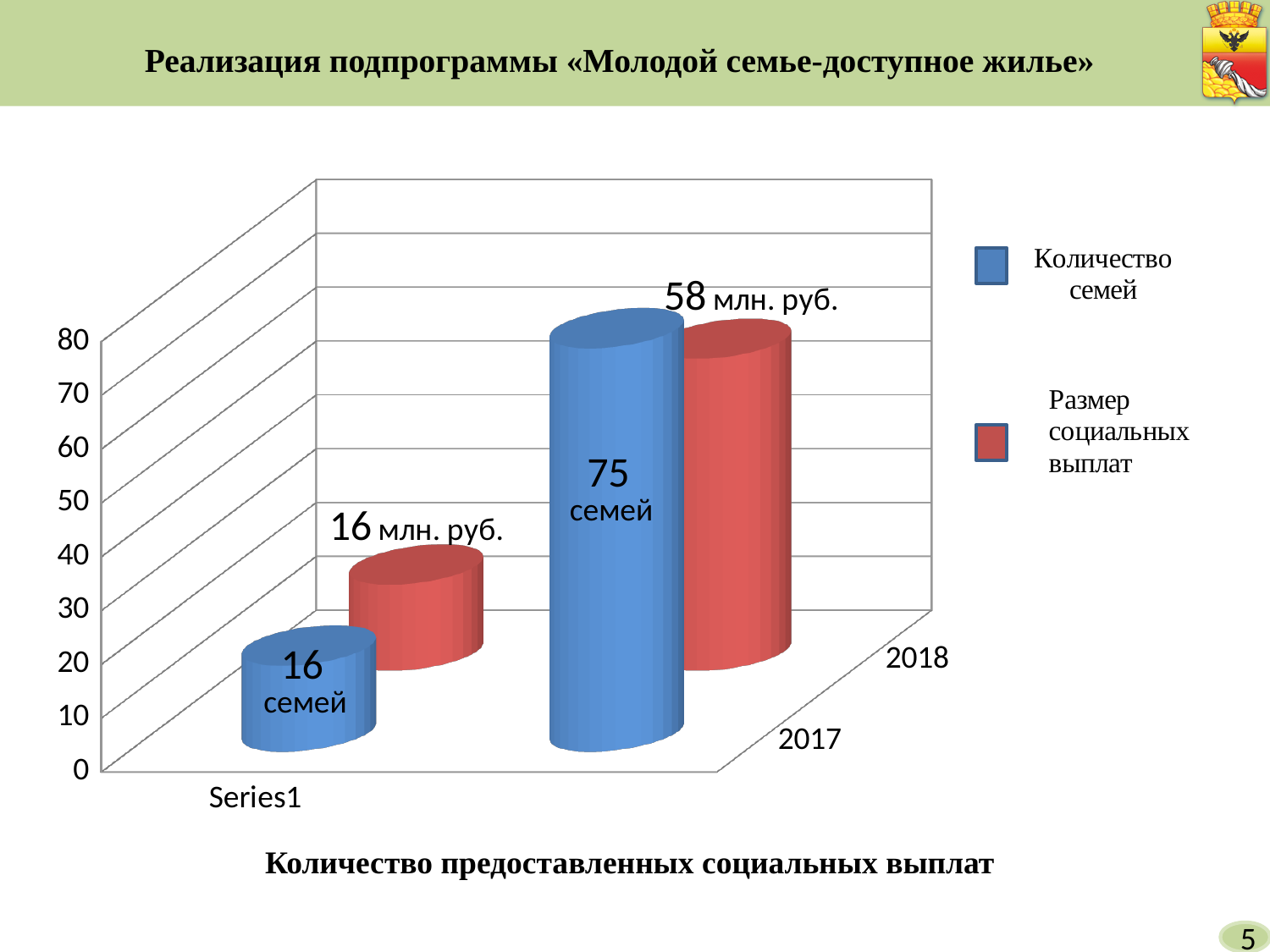
What is the difference in social payments between 2018 and 2017? 42 млн. руб. What is the size of social payments (Размер социальных выплат) for 2017? 16 млн. руб. What are the two series named in the legend? Количество семей; Размер социальных выплат How many years (categories) are shown on the chart? 2 How many series does the legend list? 2 By how many families did the number of families increase from 2017 to 2018? 59 Which year has the higher number of families, 2017 or 2018? 2018 What is the size of social payments (Размер социальных выплат) for 2018? 58 млн. руб. Does the number of families rise or fall from 2017 to 2018? rise What kind of chart is shown on the slide? bar chart How many families (Количество семей) are shown for 2017? 16 семей How many families (Количество семей) are shown for 2018? 75 семей